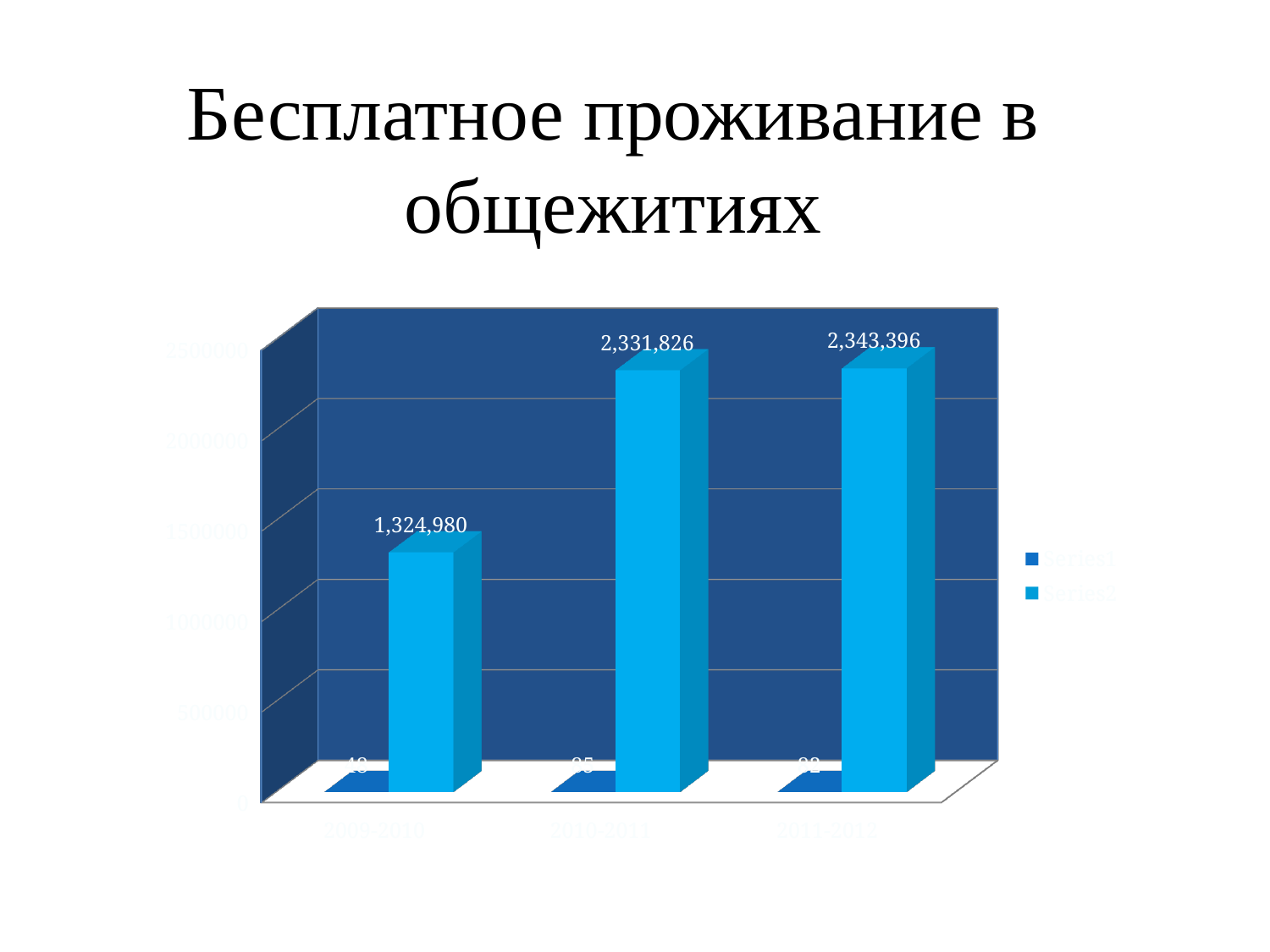
Which category has the lowest Series2 value? 2009-2010 Which is larger, the Series2 value for 2009-2010 or for 2010-2011? 2010-2011 What is the Series2 value for 2011-2012? 2,343,396 What kind of chart is shown on the slide? bar chart What is the difference between the Series2 values for 2011-2012 and 2010-2011? 11,570 What is the Series2 value for 2010-2011? 2,331,826 What is the difference between the Series2 values for 2010-2011 and 2009-2010? 1,006,846 How many series does the legend list? 2 How many categories are shown on the x axis? 3 Is the Series2 value for 2009-2010 greater or less than 1500000? less What is the Series2 value for 2009-2010? 1,324,980 Which category has the highest Series2 value? 2011-2012